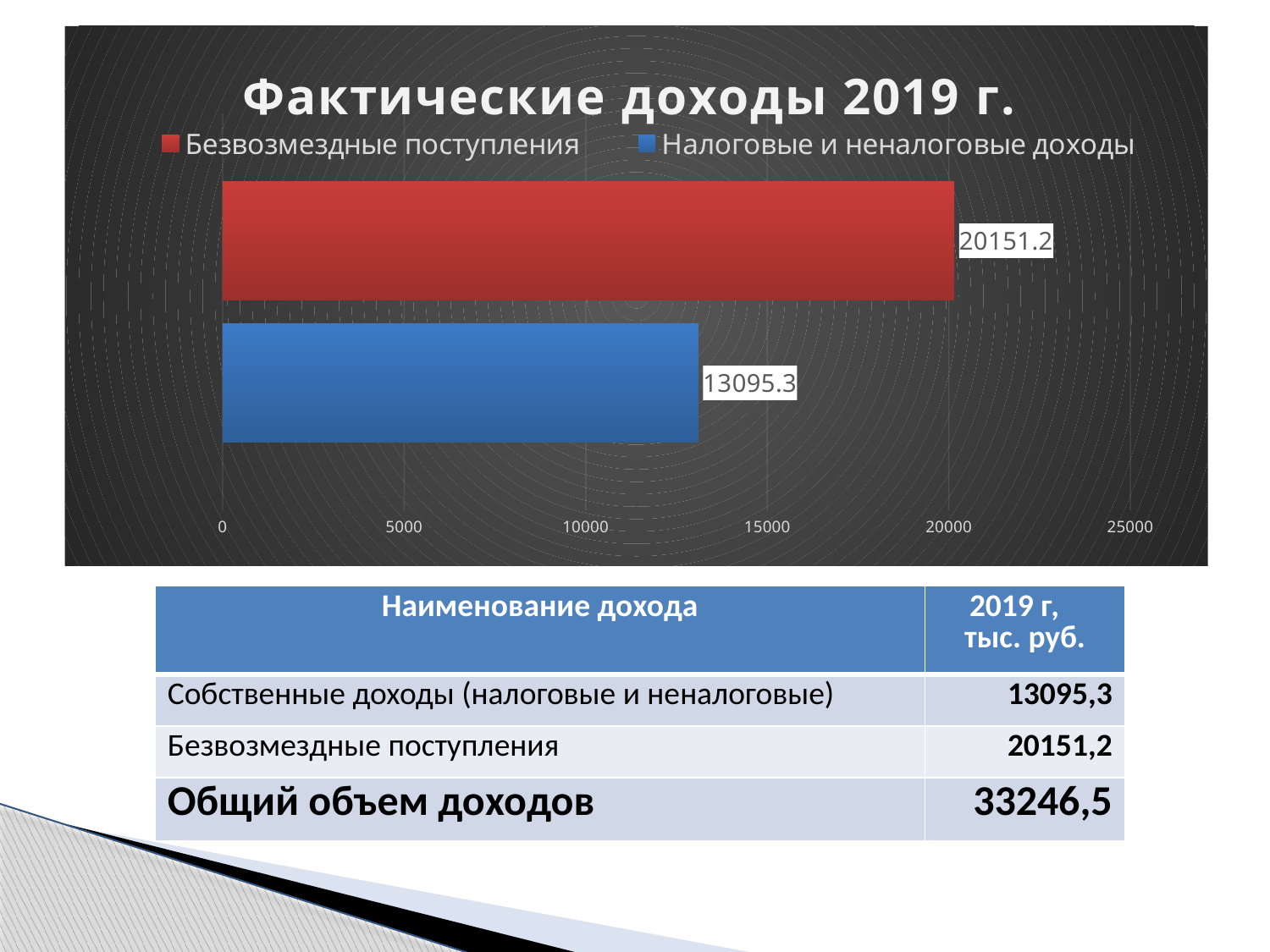
Is the value for Безвозмездные поступления greater or less than 20000? greater What is the value shown for Безвозмездные поступления in the chart? 20151.2 What is the value shown for Налоговые и неналоговые доходы in the chart? 13095.3 Which series has the lowest value in the chart? Налоговые и неналоговые доходы How many bars are plotted in the chart? 2 How many series does the chart legend list? 2 What is the title of the chart? Фактические доходы 2019 г. What kind of chart is shown on the slide? bar chart Which series has the highest value in the chart? Безвозмездные поступления Which is larger: Безвозмездные поступления or Налоговые и неналоговые доходы? Безвозмездные поступления What is the difference between the values for Безвозмездные поступления and Налоговые и неналоговые доходы? 7055.9 Is the value for Налоговые и неналоговые доходы greater or less than 15000? less